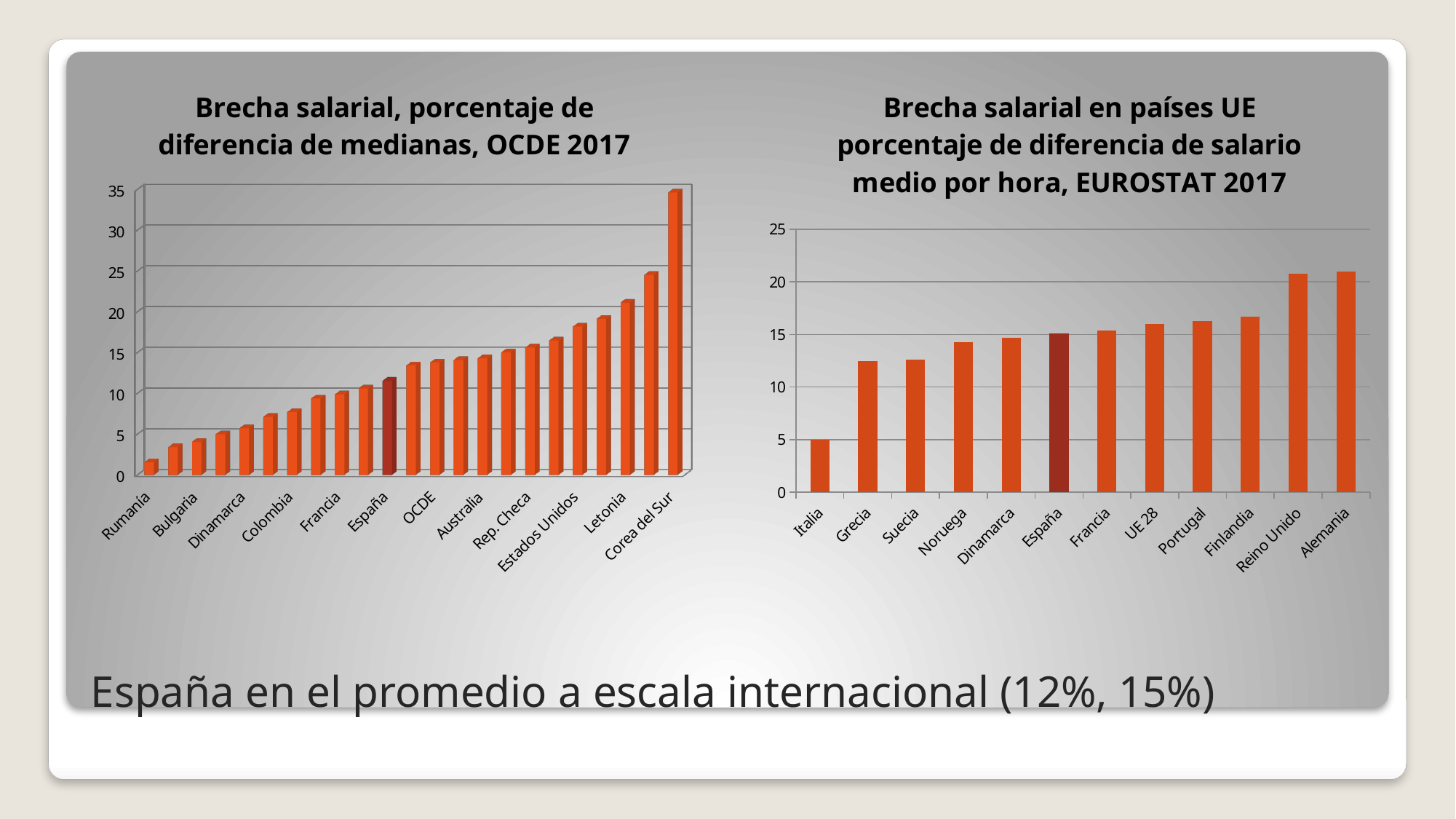
In the left chart (OCDE 2017), which category has the lowest value? Rumanía What kind of chart is the left chart titled 'Brecha salarial, porcentaje de diferencia de medianas, OCDE 2017'? Bar chart In the right chart (EUROSTAT 2017), which is larger, the value for Italia or the value for Grecia? Grecia In the left chart (OCDE 2017), is the value for Estados Unidos greater or less than 15? greater In the right chart (EUROSTAT 2017), do the values rise or fall from left to right along the x axis? Rise In the right chart (EUROSTAT 2017), which category has the lowest value? Italia In the right chart (EUROSTAT 2017), how many countries or categories are shown on the x axis? 12 In the right chart (EUROSTAT 2017), is the value for Italia greater or less than 10? less In the left chart (OCDE 2017), which category has the highest value? Corea del Sur In the left chart (OCDE 2017), is the value for Corea del Sur greater or less than 30? greater In both charts, which country's bar is highlighted in a darker red colour than the others? España